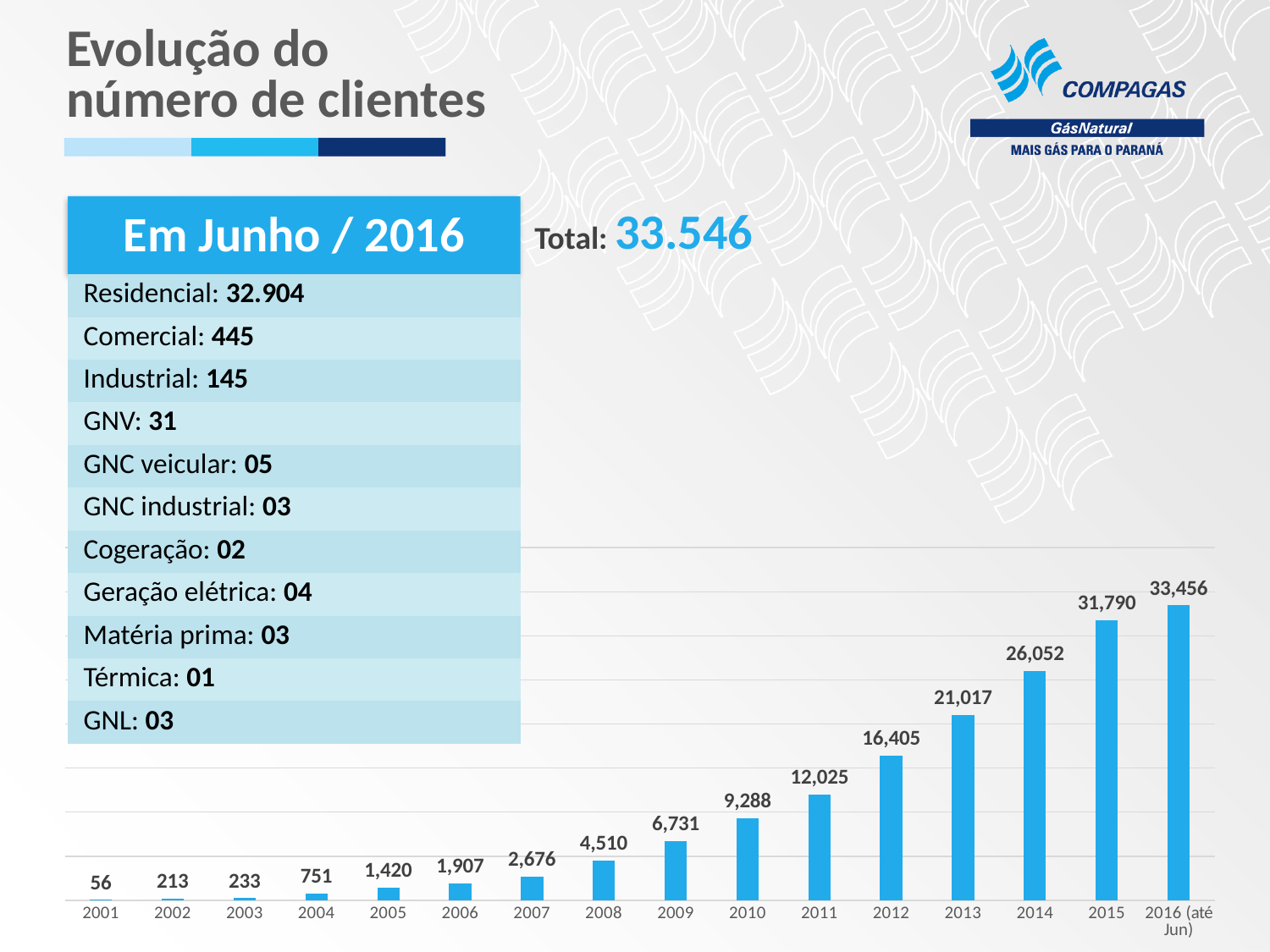
Which year has the highest value in the chart? 2016 (até Jun) What is the title of the slide containing the chart? Evolução do número de clientes Which is larger, the value for 2010 or the value for 2011? 2011 What is the value shown for 2001? 56 Do the values rise or fall from 2001 to 2016 along the x axis? rise What is the value shown for 2008? 4,510 What is the value shown for 2016 (até Jun)? 33,456 What is the difference between the values for 2015 and 2014? 5,738 How many bars (years) are plotted in the chart? 16 Which year has the lowest value in the chart? 2001 What type of chart is shown on the slide? bar chart What is the value shown for 2013? 21,017